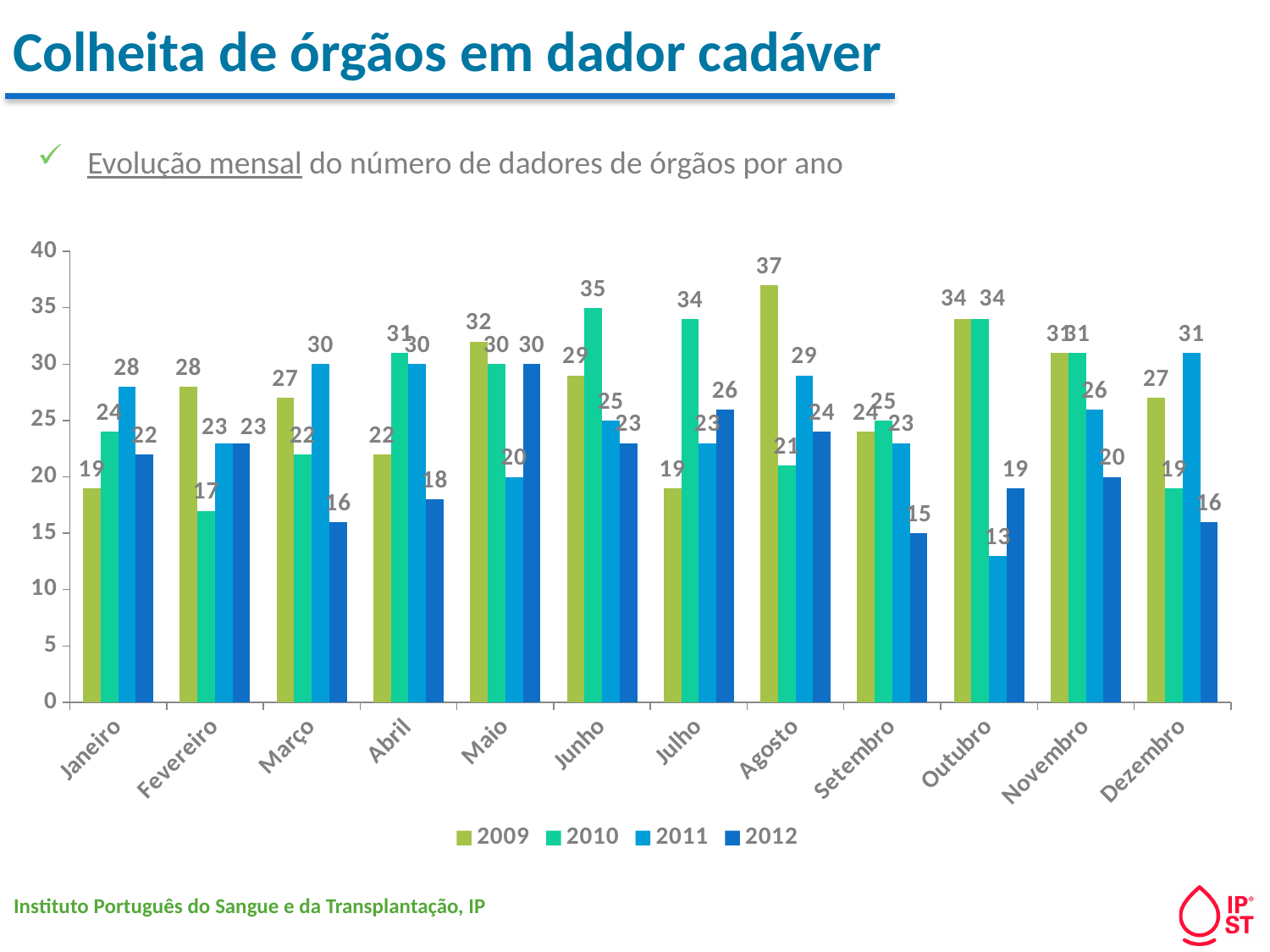
Which is larger in Dezembro, the 2011 value or the 2009 value? 2011 Which month has the lowest value for the 2012 series? Setembro Which month has the highest value for the 2010 series? Junho What is the value for 2011 in Outubro? 13 What is the value for 2009 in Agosto? 37 What is the difference between the 2009 and 2010 values in Julho? 15 What kind of chart is shown on the slide? Bar chart What is the value for 2012 in Maio? 30 What is the value for 2010 in Fevereiro? 17 How many series does the legend list? 4 How many months are shown on the x axis? 12 Which series is shown in the darkest blue colour in the legend? 2012